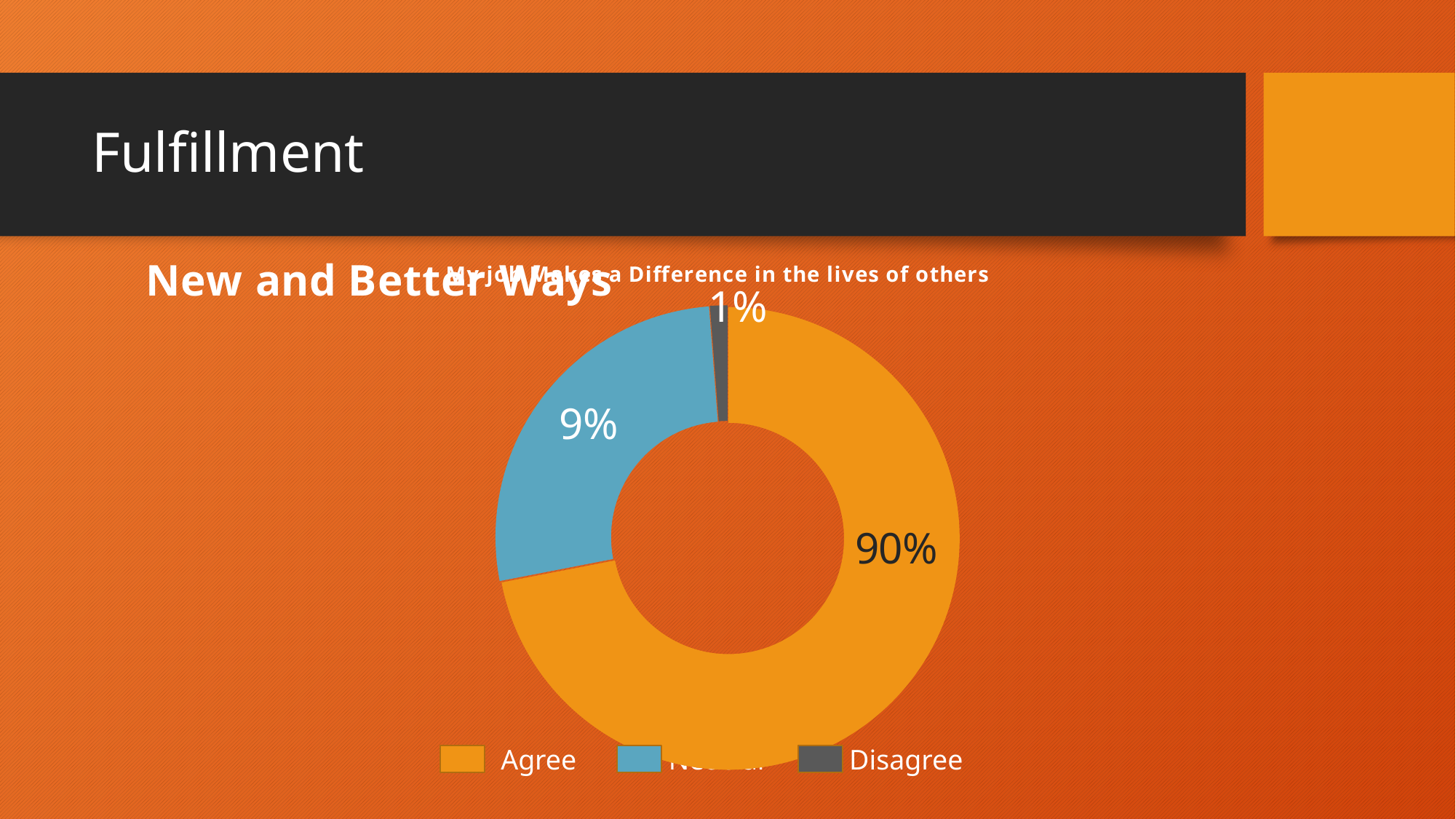
What colour is the Agree slice in the chart? orange What kind of chart is shown on the slide? doughnut chart What value is shown for the blue slice of the chart? 9% How many slices does the chart have? 3 What is the difference in percentage points between the Agree slice and the blue slice? 81 What is the difference in percentage points between Agree and Disagree? 89 What colour is the Disagree slice in the chart? dark grey Which response category has the smallest share of the chart? Disagree What percentage of respondents Agree that their job makes a difference in the lives of others? 90% What percentage of respondents Disagree? 1% Which is larger, the Agree slice or the Disagree slice? Agree Which response category has the largest share of the chart? Agree